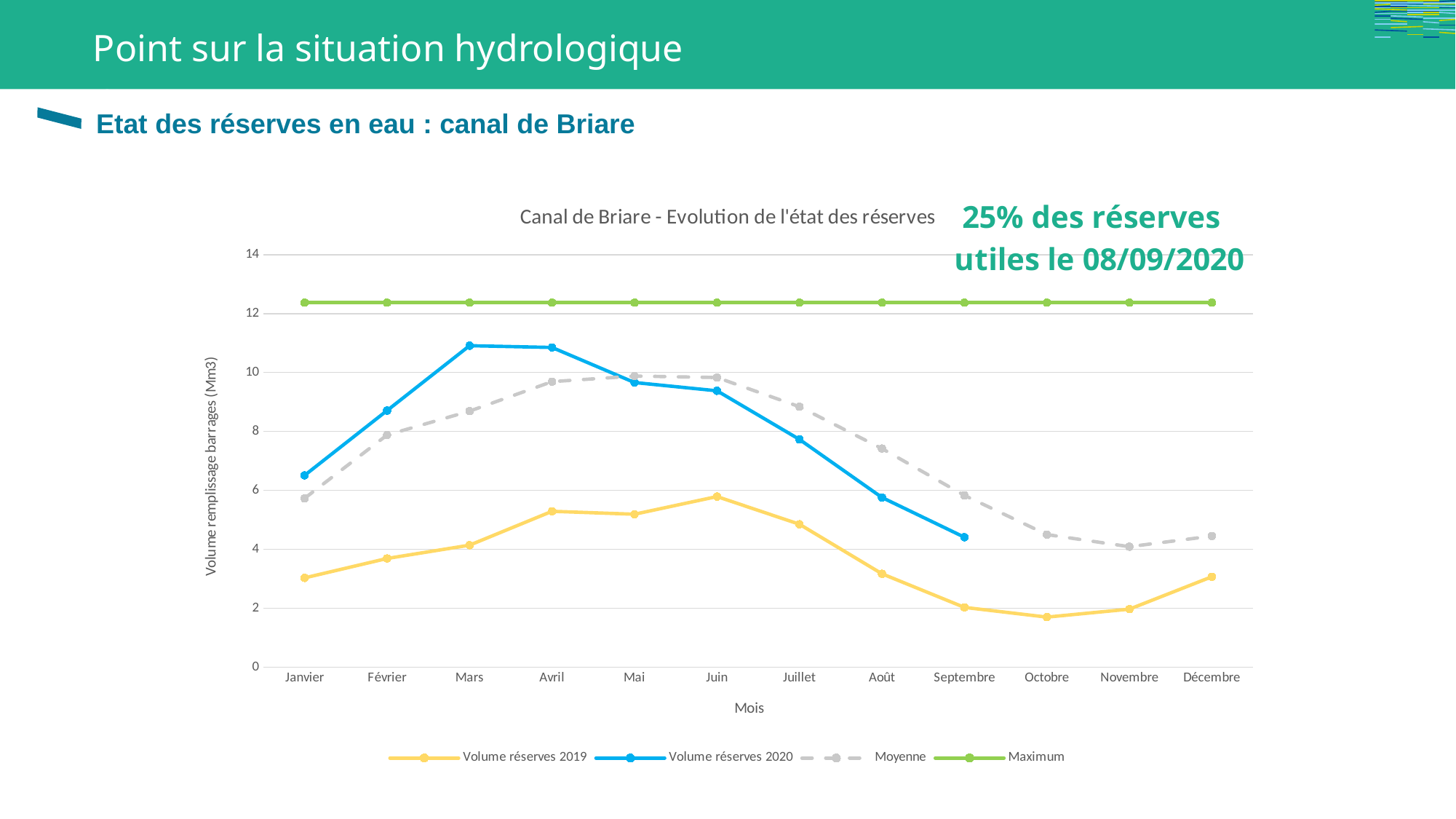
In which month is the Volume réserves 2019 series highest? Juin What kind of chart is shown on the slide? line chart How many series does the legend list? 4 Is the Maximum series greater or less than 12? greater Is the value for Volume réserves 2019 in Septembre greater or less than 4? less How many data points does the Volume réserves 2020 series have? 9 Is the value for Volume réserves 2020 in Janvier greater or less than 6? greater Does the Volume réserves 2020 series rise or fall from Avril to Septembre? fall How many months are shown on the x axis? 12 In Juin, which is larger: Volume réserves 2019 or Volume réserves 2020? Volume réserves 2020 What is the title of the chart? Canal de Briare - Evolution de l'état des réserves